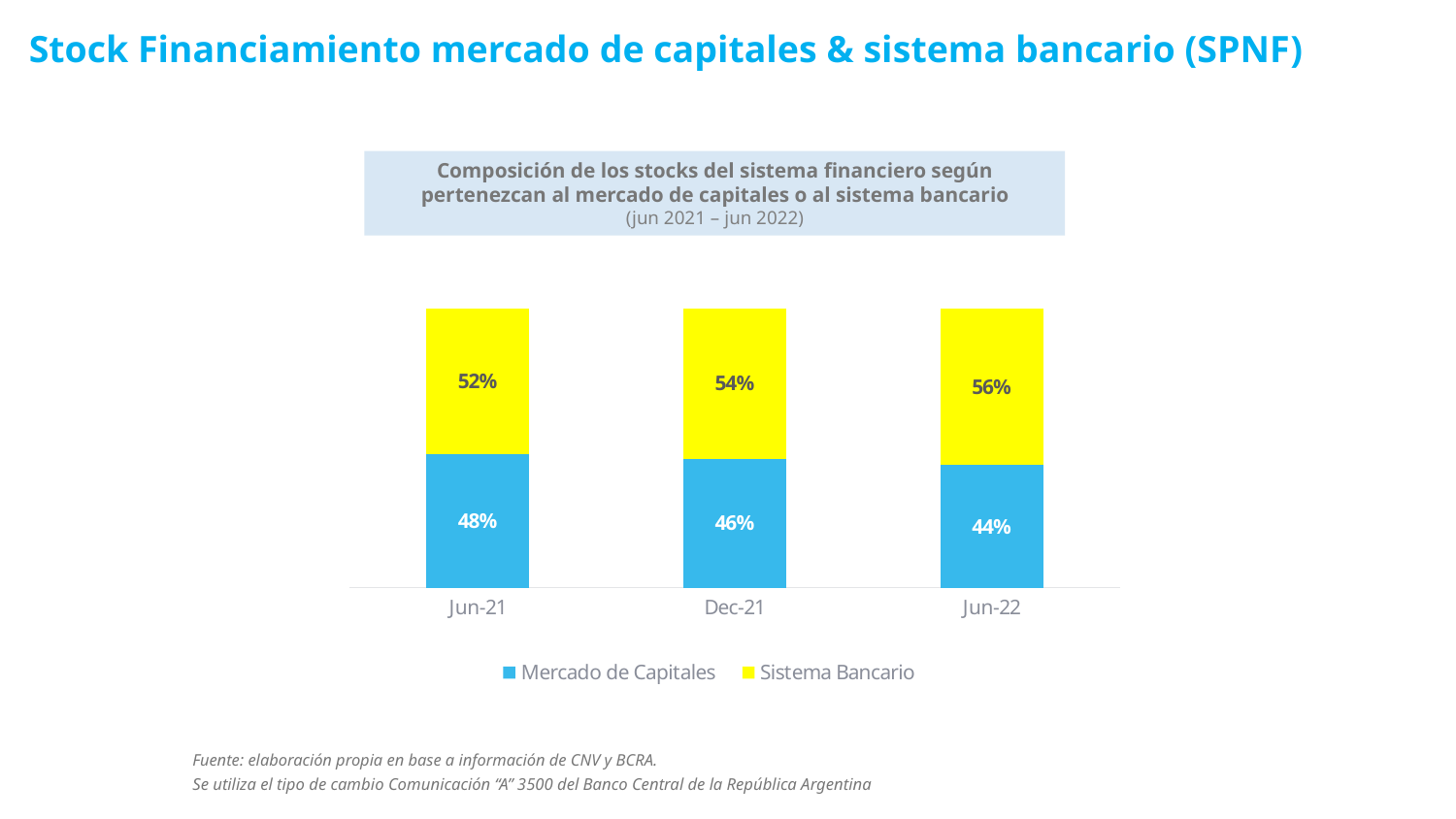
What is the value for Mercado de Capitales in Jun-22? 44% In Dec-21, which is larger: Mercado de Capitales or Sistema Bancario? Sistema Bancario How many series does the legend list? 2 In which period is the Mercado de Capitales share lowest? Jun-22 In which period is the Sistema Bancario share highest? Jun-22 How many periods are shown on the x axis? 3 Does the Mercado de Capitales share rise or fall from Jun-21 to Jun-22? Fall What is the difference between the Sistema Bancario and Mercado de Capitales shares in Jun-22? 12% What kind of chart is shown? Stacked bar chart What is the value for Sistema Bancario in Dec-21? 54% What is the value for Sistema Bancario in Jun-22? 56% What is the value for Mercado de Capitales in Jun-21? 48%